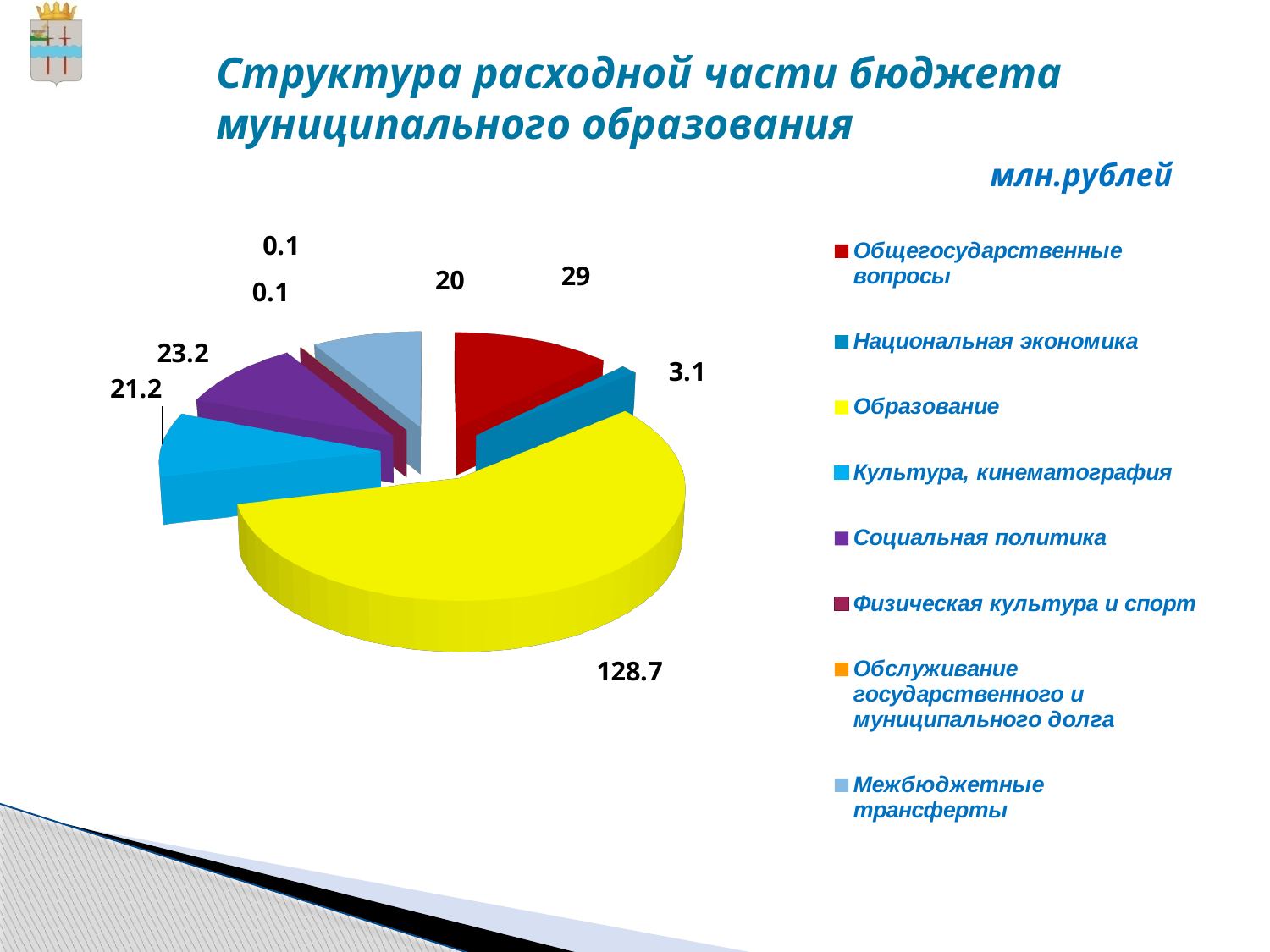
What unit is stated for the values on the slide? млн.рублей What is the difference between the values for Образование and Общегосударственные вопросы? 99.7 Which category has the largest slice of the pie? Образование What is the value for Социальная политика? 23.2 How many categories does the legend list? 8 Which is larger, Социальная политика or Культура, кинематография? Социальная политика What is the value for Образование? 128.7 What is the value for Национальная экономика? 3.1 What is the value for Культура, кинематография? 21.2 What is the value for Общегосударственные вопросы? 29 What kind of chart is shown on the slide? pie chart What is the value for Межбюджетные трансферты? 20